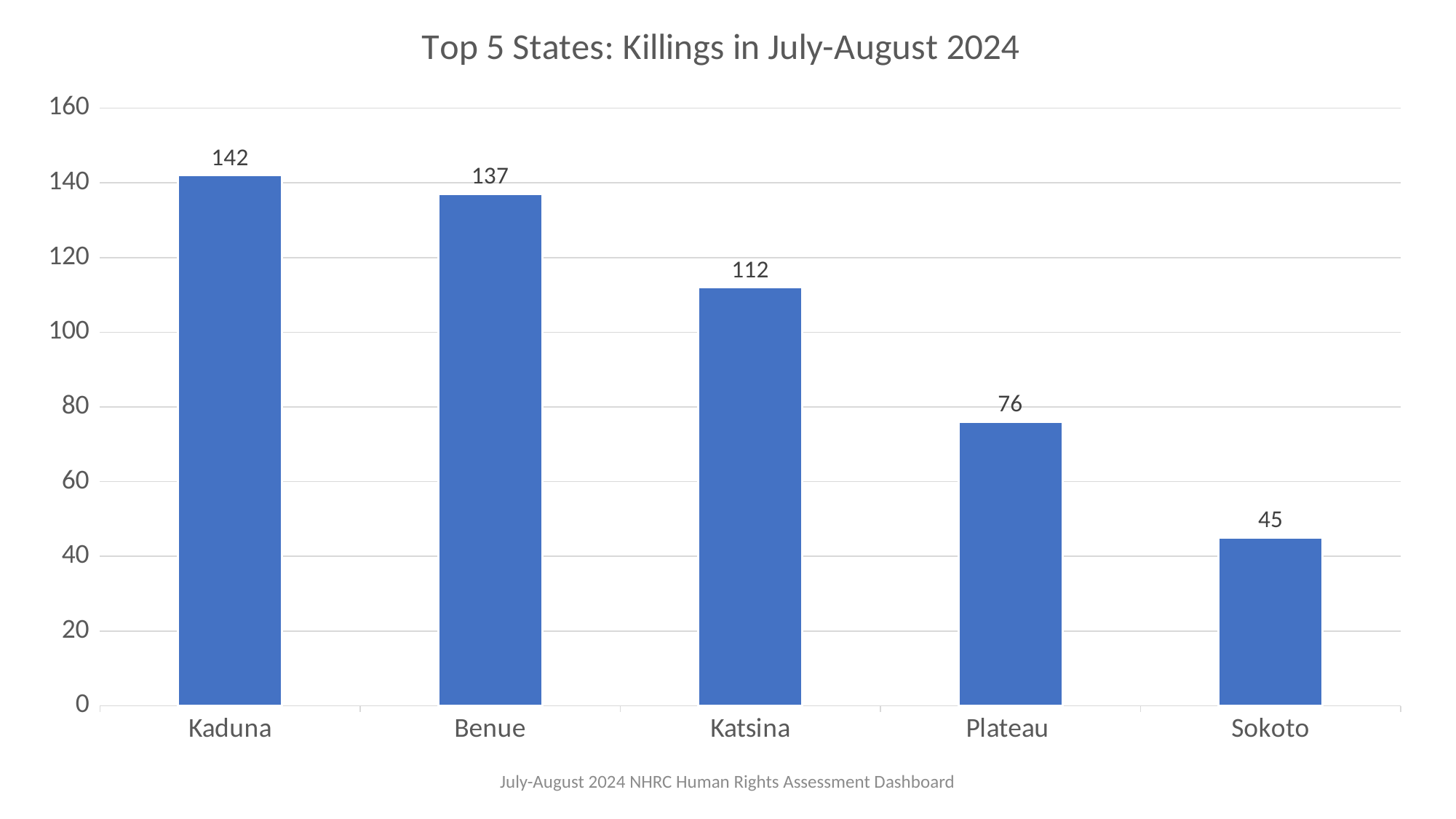
Which state has the highest number of killings? Kaduna Which is larger, the value for Katsina or the value for Plateau? Katsina What is the difference between the values for Kaduna and Benue? 5 What is the title of the chart? Top 5 States: Killings in July-August 2024 How many states are shown on the chart? 5 What is the value for Sokoto? 45 Which state has the lowest number of killings? Sokoto Is the value for Benue greater or less than 120? greater What kind of chart is this? Bar chart What is the value for Katsina? 112 What is the difference between the values for Plateau and Sokoto? 31 What is the value for Kaduna? 142